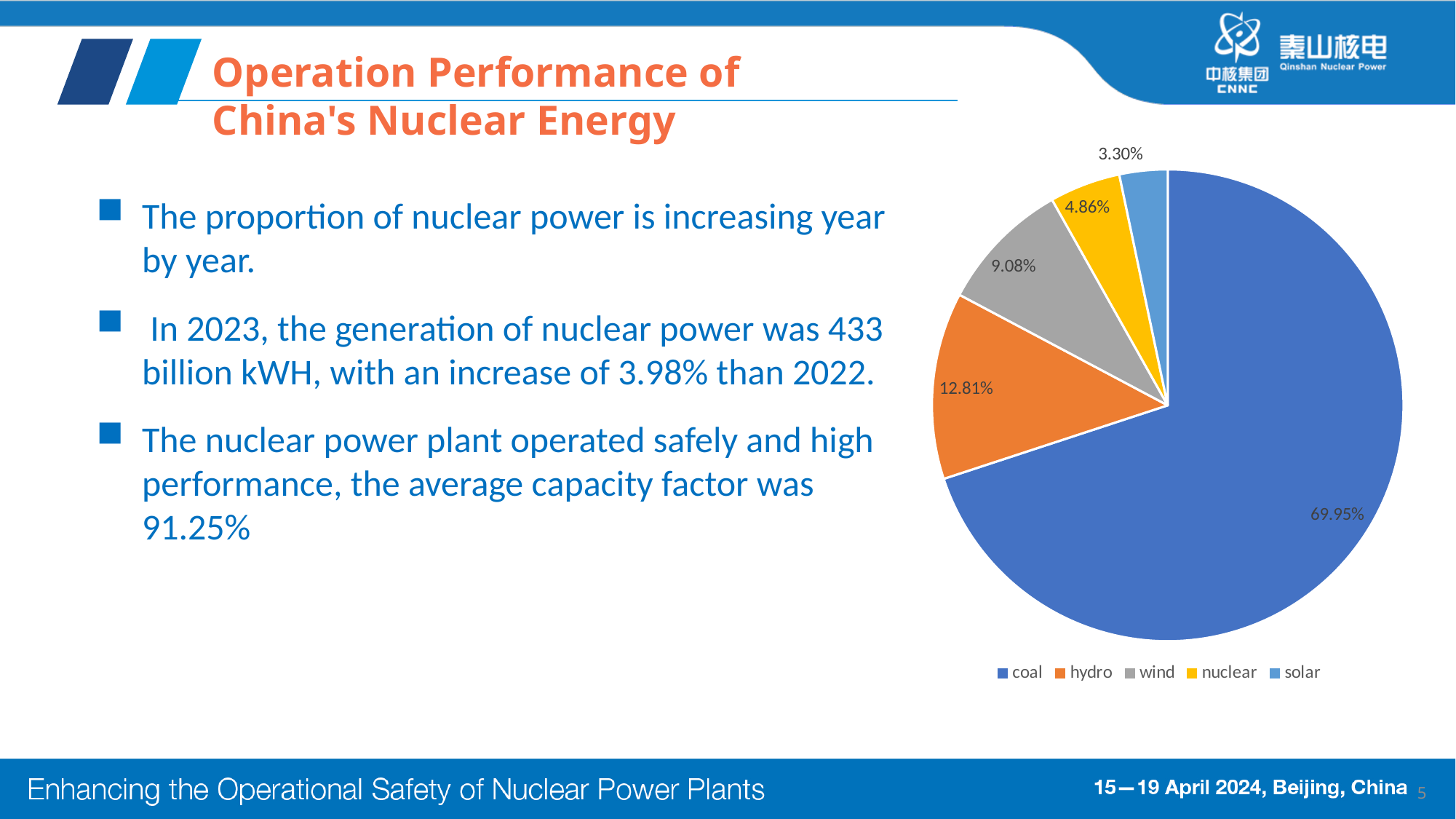
What is the value shown for hydro in the pie chart? 12.81% What is the value shown for solar in the pie chart? 3.30% What share of the pie does coal account for? 69.95% Which category has the smallest slice of the pie? solar What kind of chart is shown on the slide? pie chart How many categories does the pie chart show? 5 Which category has the largest slice of the pie? coal What is the value shown for nuclear in the pie chart? 4.86% What is the value shown for wind in the pie chart? 9.08% Which is larger, the share for nuclear or the share for solar? nuclear What is the difference between the hydro and wind shares? 3.73% What colour is the nuclear slice in the pie chart? yellow